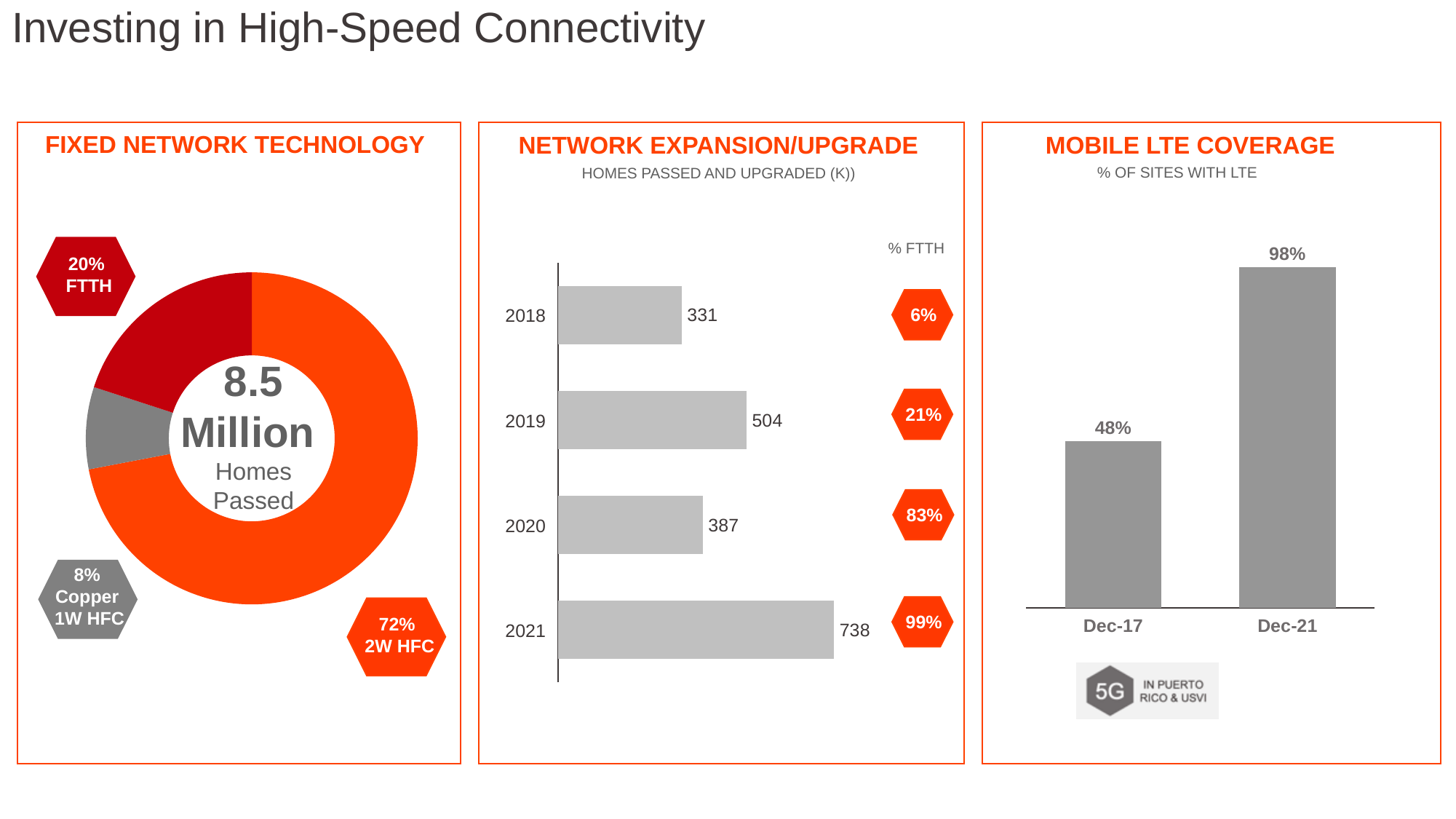
In the Fixed Network Technology chart, what share of homes passed is 2W HFC? 72% In the Fixed Network Technology chart, which technology has the smallest share? Copper 1W HFC How many years are shown in the Network Expansion/Upgrade chart? 4 What kind of chart is the Fixed Network Technology chart? Donut (pie) chart What total number of homes passed is shown in the centre of the Fixed Network Technology chart? 8.5 Million In the Network Expansion/Upgrade chart, what is the % FTTH for 2020? 83% In the Network Expansion/Upgrade chart, which year has the highest homes passed and upgraded? 2021 In the Mobile LTE Coverage chart, what is the % of sites with LTE at Dec-21? 98% In the Network Expansion/Upgrade chart, what is the difference in homes passed and upgraded (K) between 2021 and 2020? 351 In the Fixed Network Technology chart, what share of homes passed is FTTH? 20% In the Network Expansion/Upgrade chart, how many homes were passed and upgraded (K) in 2019? 504 In the Mobile LTE Coverage chart, what is the difference in % of sites with LTE between Dec-21 and Dec-17? 50%